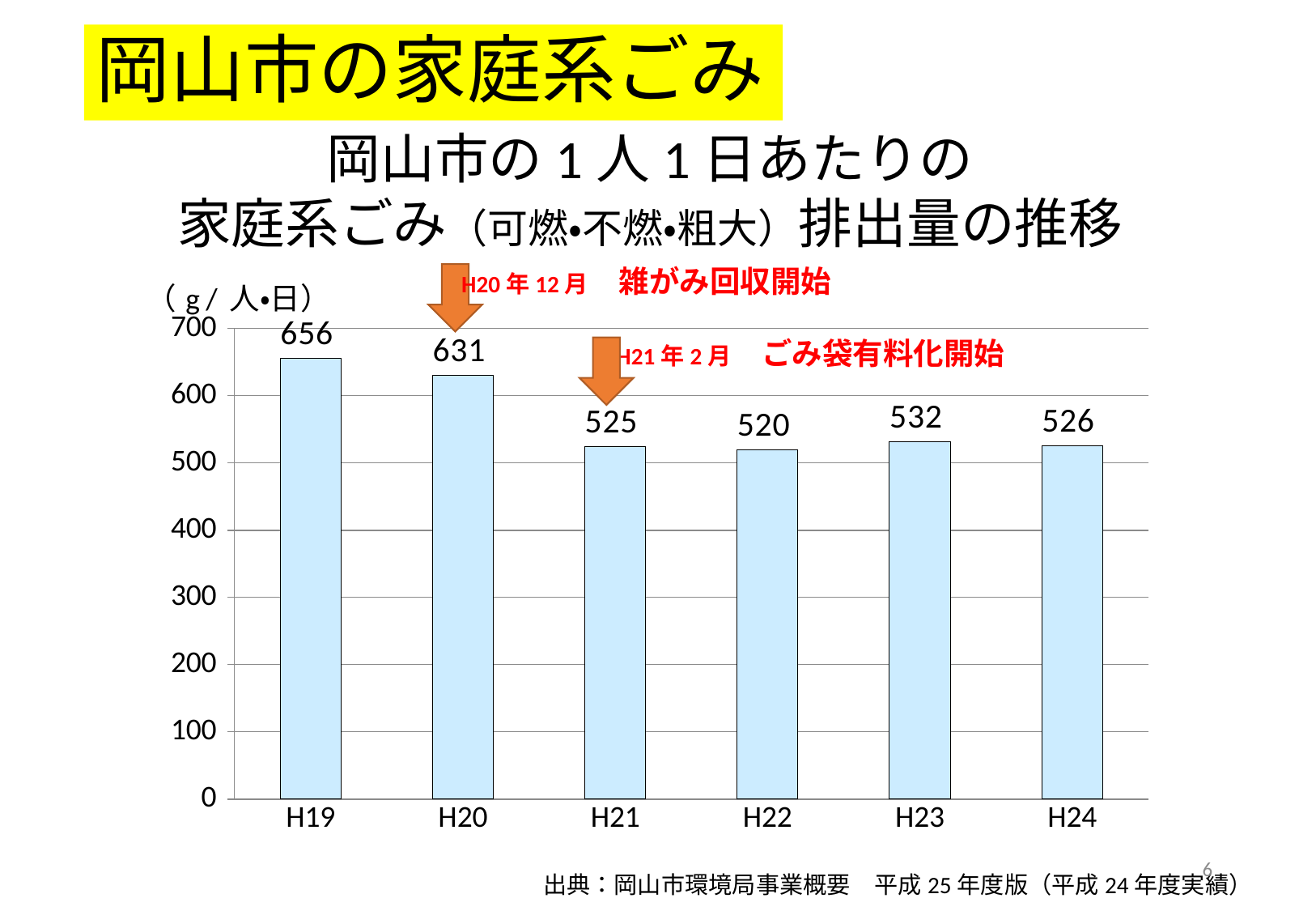
Is the value for H21 greater or less than 600? less Which is larger, the value for H23 or the value for H24? H23 What unit is shown for the y axis? g/人・日 What is the value for H23? 532 Which year has the lowest value? H22 How many years are shown on the x axis? 6 What is the difference between the values for H20 and H21? 106 Which year has the highest value? H19 What kind of chart is this? bar chart What is the value for H19? 656 What is the value for H22? 520 What is the difference between the values for H19 and H20? 25